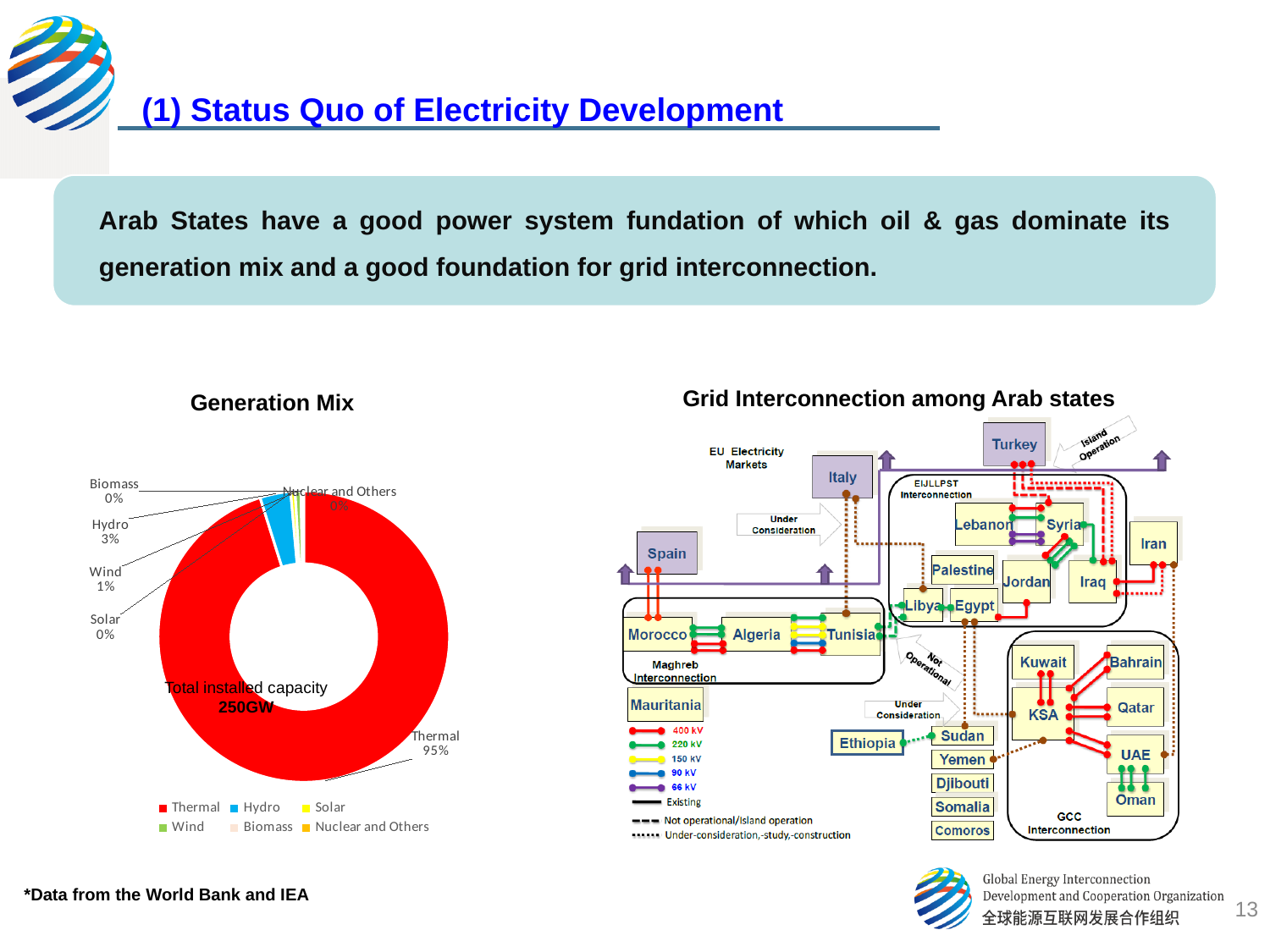
In the Generation Mix chart, what is the value shown for Hydro? 3% What total installed capacity is printed in the centre of the Generation Mix chart? 250GW What is the title of the chart on the left side of the slide? Generation Mix Which category has the largest share in the Generation Mix chart? Thermal How many categories are shown in the Generation Mix chart? 6 In the Generation Mix chart, what share does Thermal account for? 95% What type of chart is the Generation Mix chart? doughnut chart In the Generation Mix chart, what percentage is shown for Solar? 0% How many entries does the legend of the Generation Mix chart list? 6 In the Generation Mix chart, what is the difference in percentage points between Thermal and Hydro? 92 In the Generation Mix chart, what percentage is shown for Wind? 1% In the Generation Mix chart, which is larger, Hydro or Wind? Hydro